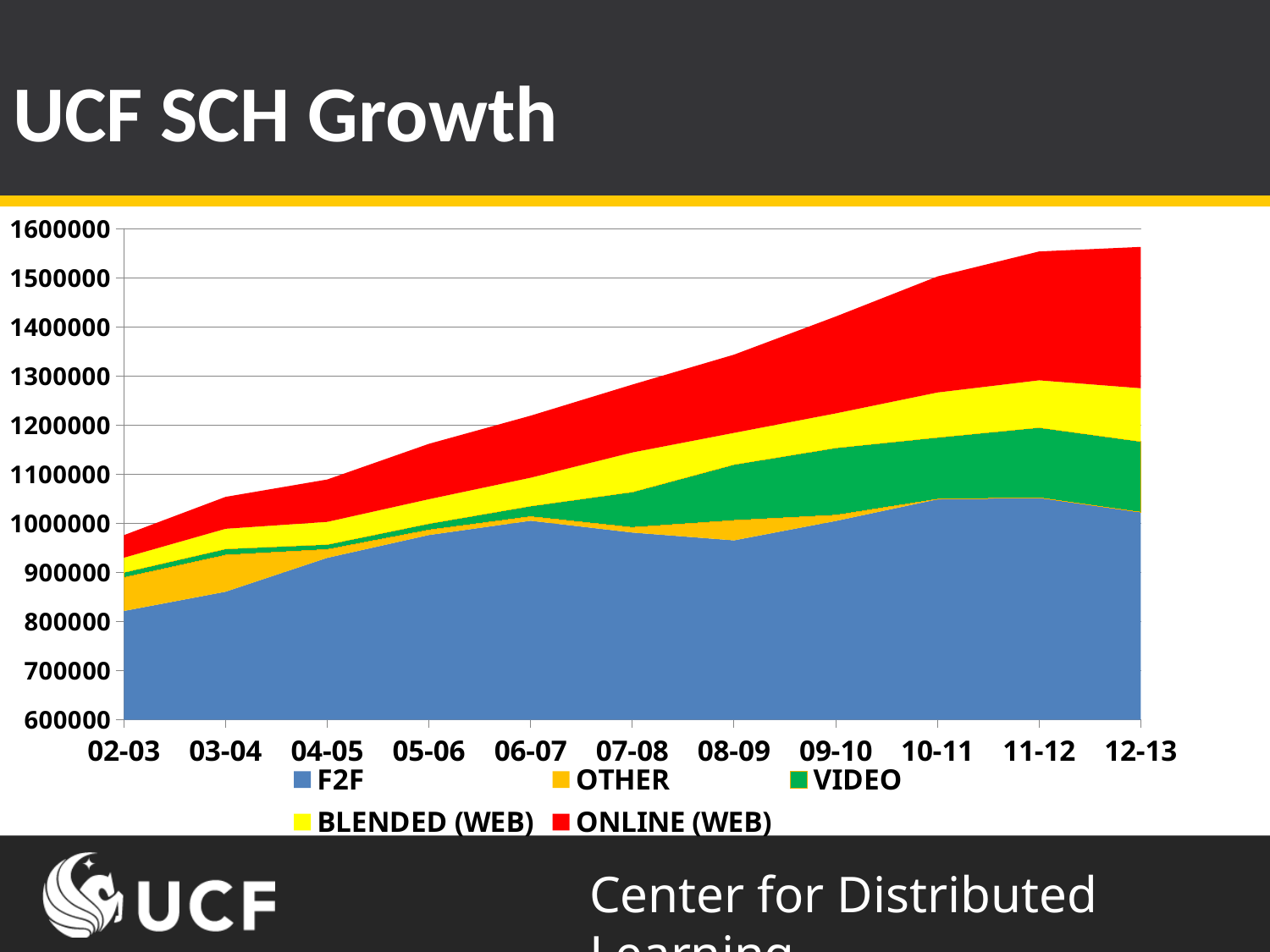
Is the total SCH (top of the stack) for 12-13 greater or less than 1500000? greater Is the F2F value for 02-03 greater or less than 900000? less What kind of chart is shown on the slide? Stacked area chart How many academic years are plotted along the x axis? 11 Which year has the lowest total SCH? 02-03 Is the F2F value for 10-11 greater or less than 1000000? greater What is the title of the chart slide? UCF SCH Growth Does the total SCH rise or fall from 02-03 to 12-13? Rises In 12-13, which series is larger, F2F or ONLINE (WEB)? F2F How many series does the legend list? 5